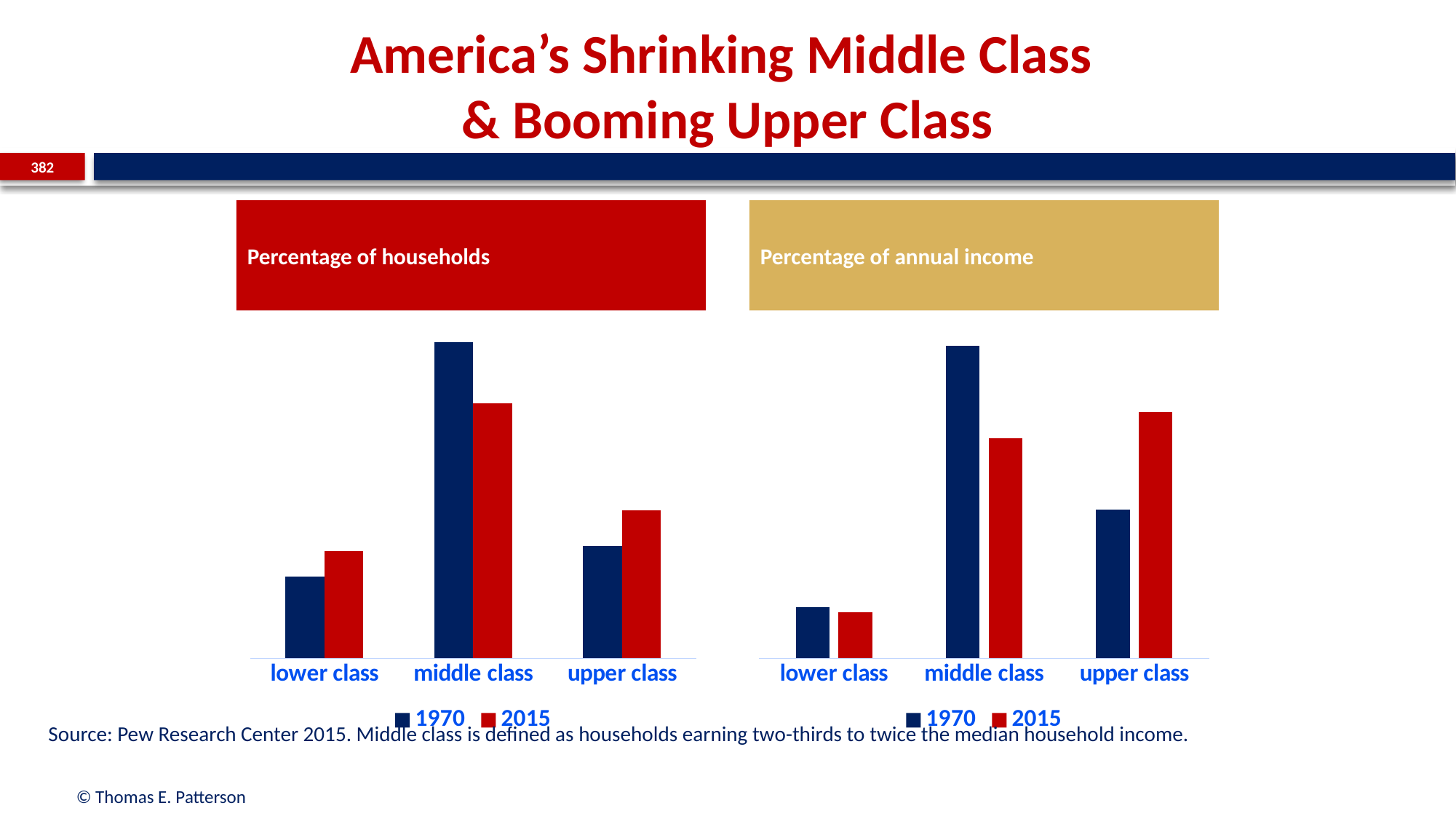
What are the two legend entries of the 'Percentage of households' chart? 1970 and 2015 How many series does the legend of the 'Percentage of annual income' chart list? 2 In the 'Percentage of annual income' chart, which category has the highest value for 1970? middle class In the 'Percentage of households' chart, which category has the highest value for 1970? middle class In the 'Percentage of annual income' chart, for middle class, which is larger: 1970 or 2015? 1970 In the 'Percentage of annual income' chart, which category has the lowest value for 2015? lower class In the 'Percentage of households' chart, for middle class, which is larger: 1970 or 2015? 1970 In the 'Percentage of households' chart, for upper class, which is larger: 1970 or 2015? 2015 In the 'Percentage of households' chart, which category has the lowest value for 1970? lower class What kind of chart is the 'Percentage of households' chart on the left? bar chart How many categories are shown on the x axis of the 'Percentage of households' chart? 3 In the 'Percentage of annual income' chart, which category has the highest value for 2015? upper class